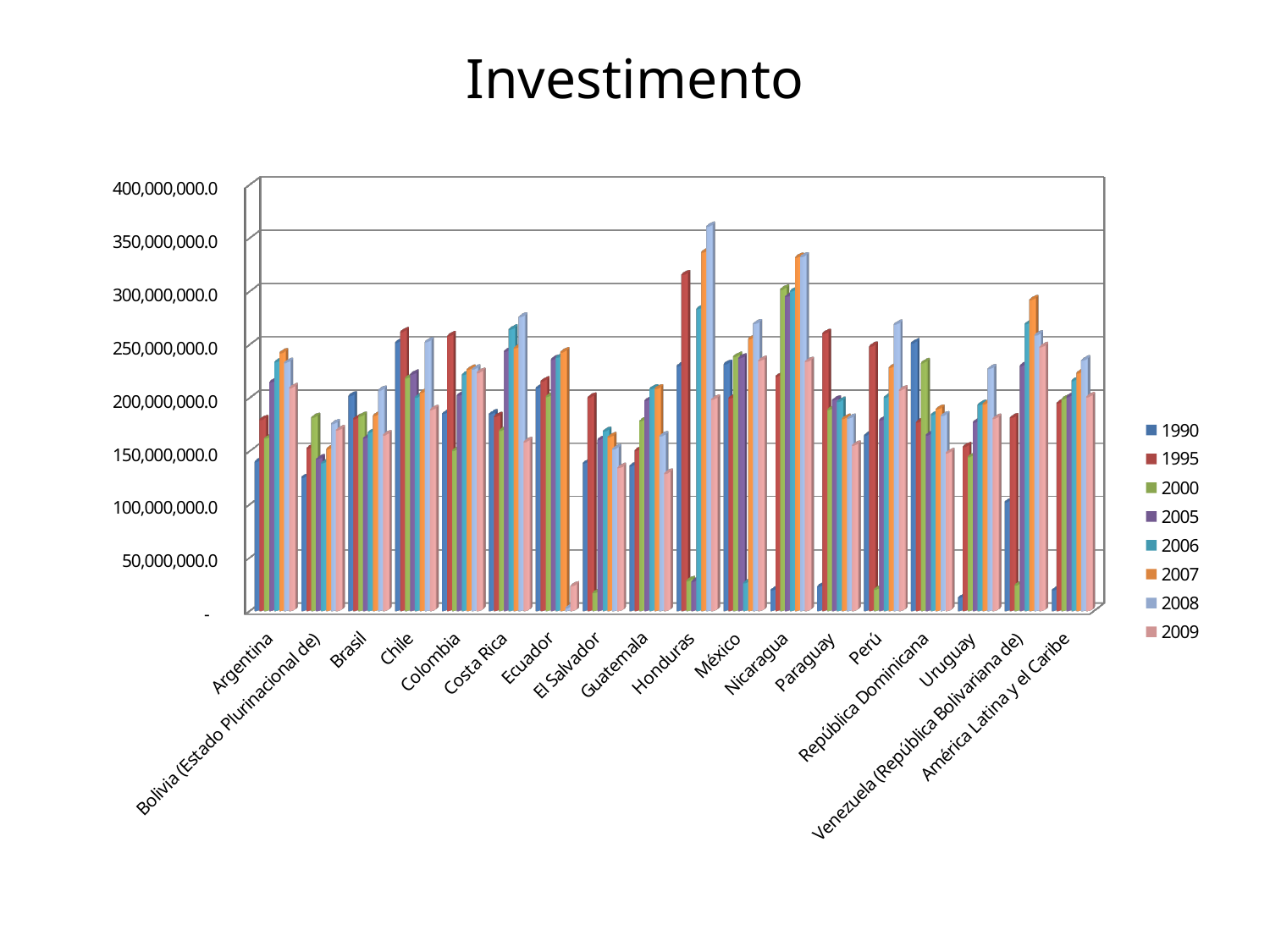
How many series does the legend list? 8 How many categories are shown on the x axis? 18 Which is larger for Chile: the 1995 value or the 2000 value? 1995 For Honduras, do the values rise or fall from 2005 to 2008? rise Is the 2008 value for Honduras greater or less than 350,000,000? greater What kind of chart is shown on the slide? bar chart Which category has the highest 2008 value? Honduras What is the title of the chart? Investimento Is the 2007 value for Venezuela (República Bolivariana de) greater or less than 250,000,000? greater Is the 2000 value for Honduras greater or less than 50,000,000? less For Honduras, which year has the tallest bar? 2008